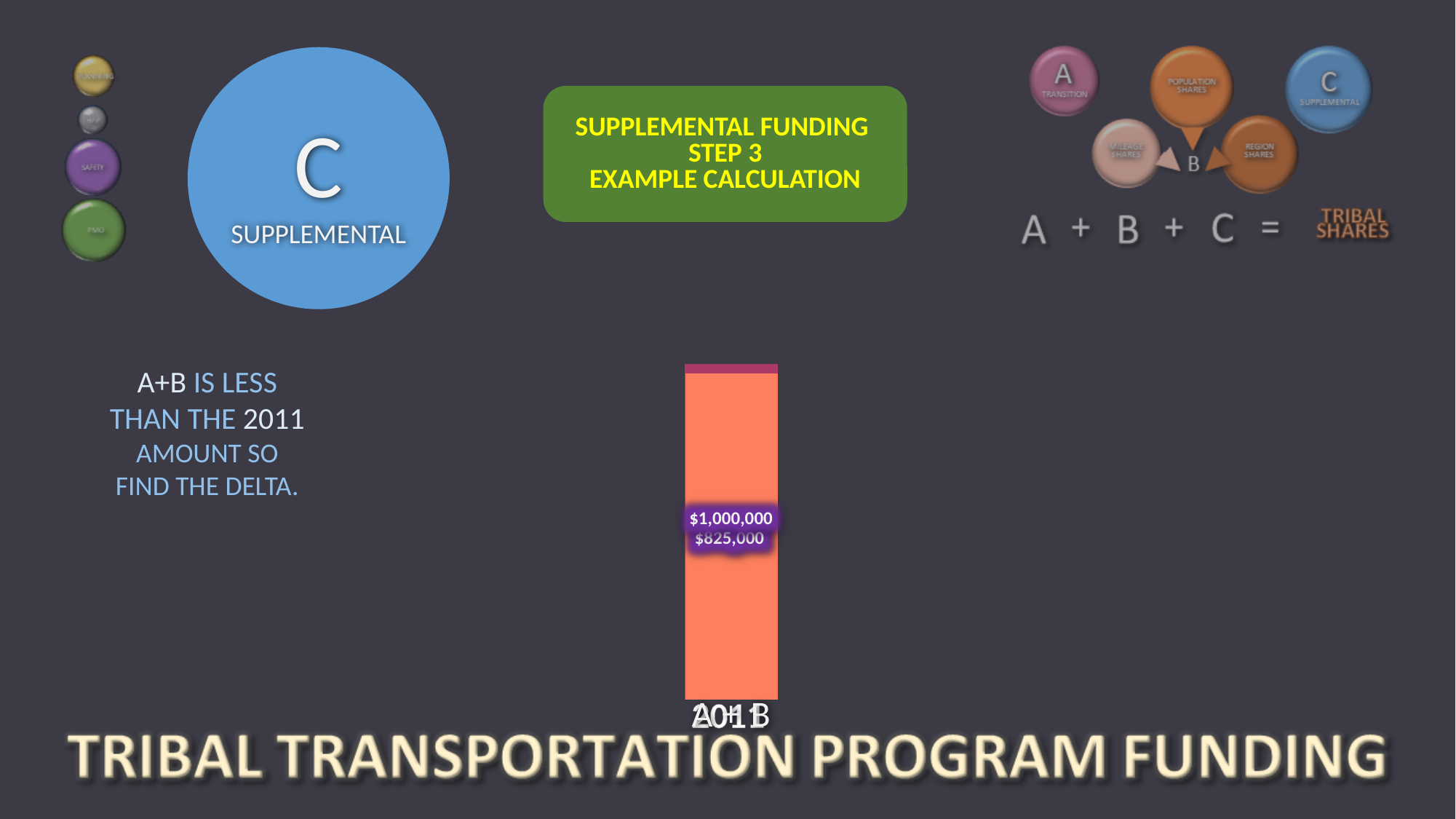
What is the value labelled for the A+B amount on the bar chart? $825,000 What is the smaller of the two values labelled on the bar chart? $825,000 According to the slide, is the A+B amount larger or smaller than the 2011 amount? smaller What kind of chart is shown on the slide? bar chart What is the larger of the two values labelled on the bar chart? $1,000,000 What is the difference between the two values labelled on the bar chart, $1,000,000 and $825,000? $175,000 How many data labels are printed on the bar chart? 2 What is the value labelled for the 2011 amount on the bar chart? $1,000,000 What colour is the large bar on the chart? orange